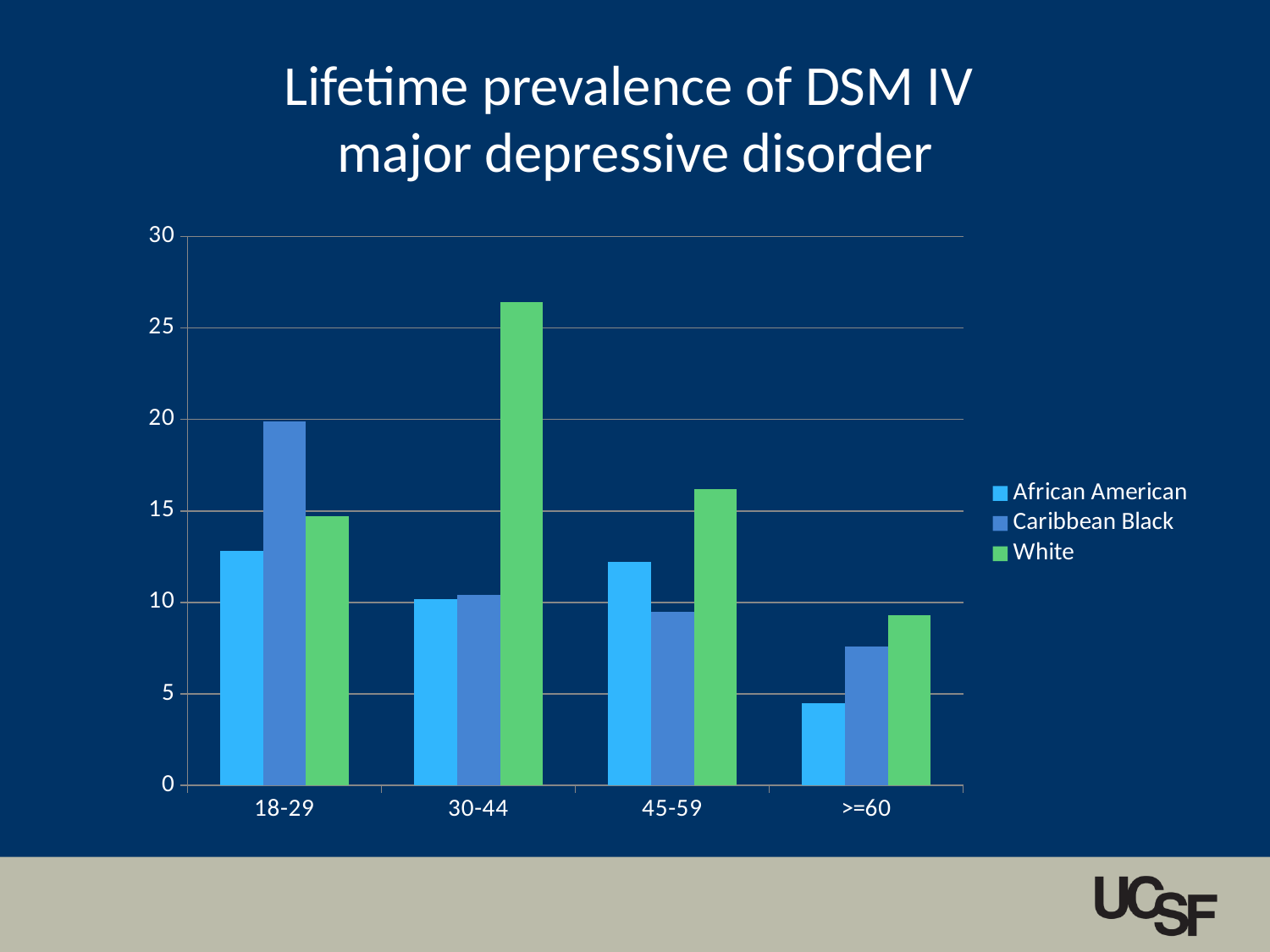
What is the title of the chart? Lifetime prevalence of DSM IV major depressive disorder What kind of chart is shown on the slide? bar chart How many series does the legend list? 3 In the 18-29 age group, which is larger: Caribbean Black or White? Caribbean Black Is the value for African American in the >=60 age group greater or less than 5? less Which series has the lowest value in the >=60 age group? African American Is the value for Caribbean Black in the 18-29 age group greater or less than 15? greater Is the value for White in the 30-44 age group greater or less than 25? greater In the 45-59 age group, which is larger: African American or Caribbean Black? African American How many age groups are shown on the x axis? 4 Which age group has the highest value for the White series? 30-44